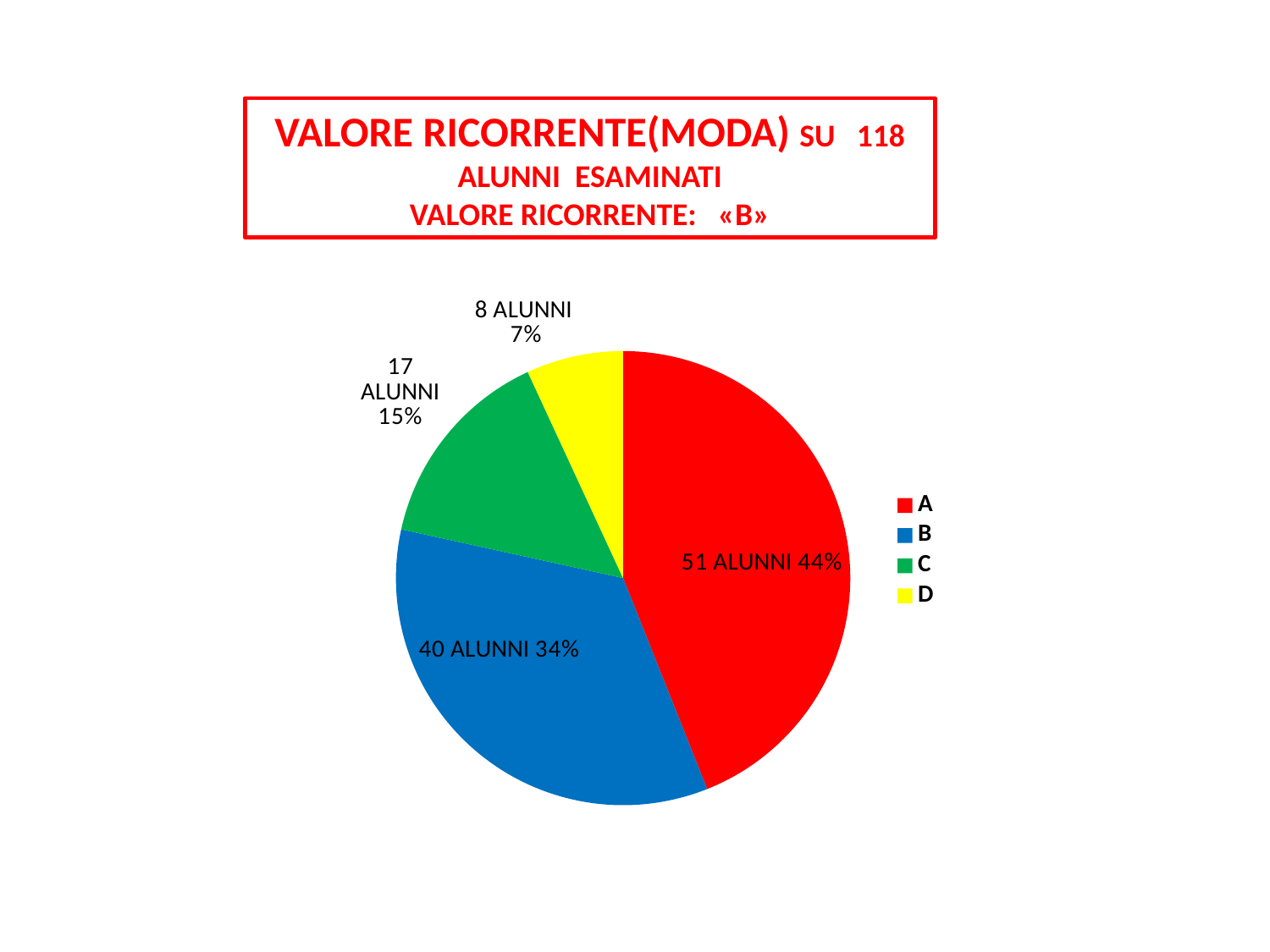
What percentage of the pie does category D represent? 7% What colour is the slice for category B? blue How many alunni are in category C? 17 ALUNNI How many alunni are in category A? 51 ALUNNI Which category has the largest slice? A What percentage of the pie does category B represent? 34% Which category has more alunni, C or D? C What kind of chart is shown on the slide? pie chart How many slices does the pie chart have? 4 Which category has the smallest slice? D How many entries does the legend list? 4 What is the difference in number of alunni between category A and category B? 11